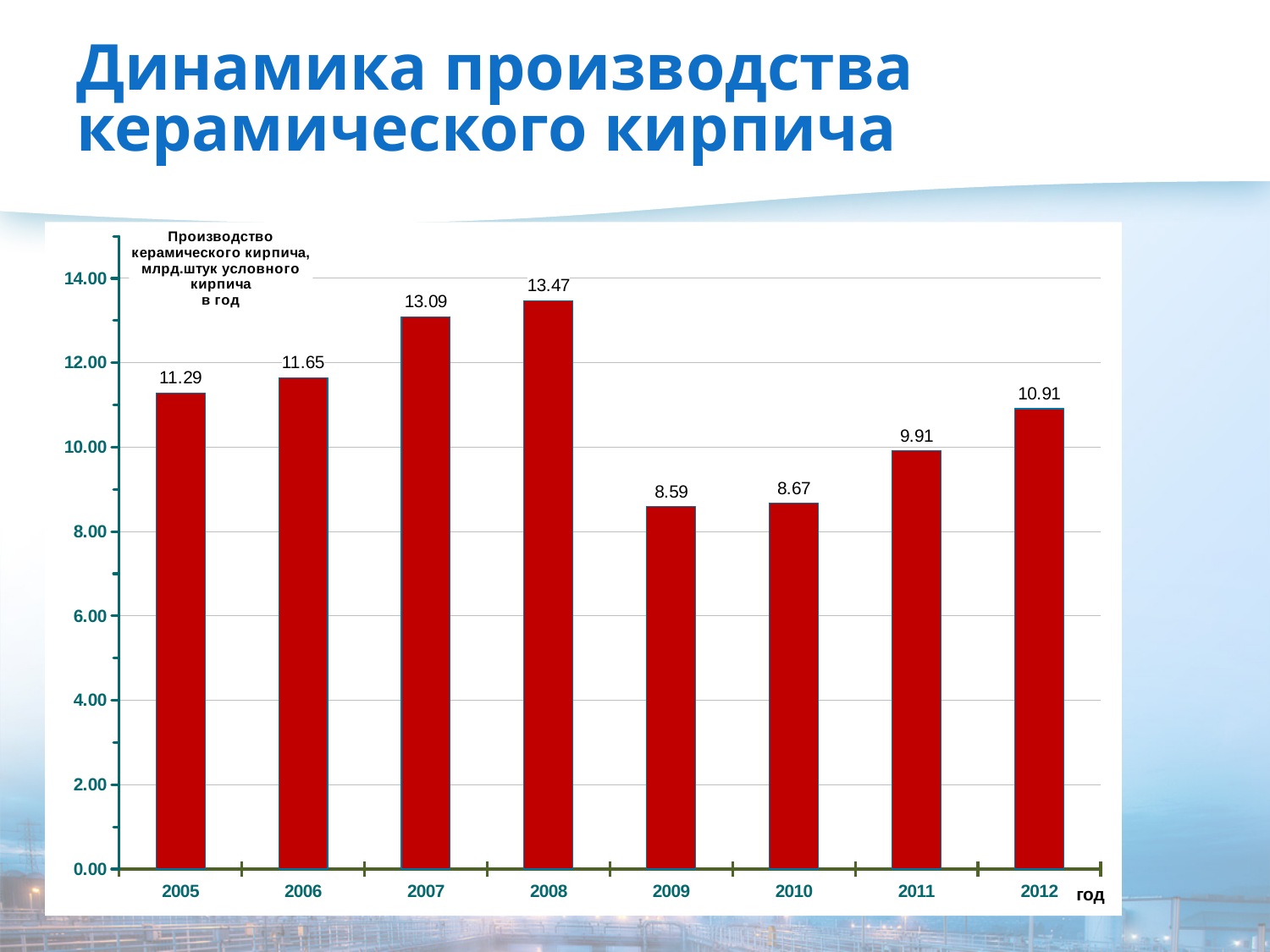
Which is larger, the value for 2007 or the value for 2011? 2007 Do the values rise or fall from 2005 to 2008? rise What is the value for 2012? 10.91 What is the value for 2010? 8.67 What is the difference between the values for 2008 and 2009? 4.88 What is the difference between the values for 2006 and 2005? 0.36 Which year has the lowest value? 2009 How many years are shown on the x axis? 8 What is the value for 2008? 13.47 What kind of chart is this? bar chart Is the value for 2011 greater or less than 10.00? less Which year has the highest value? 2008